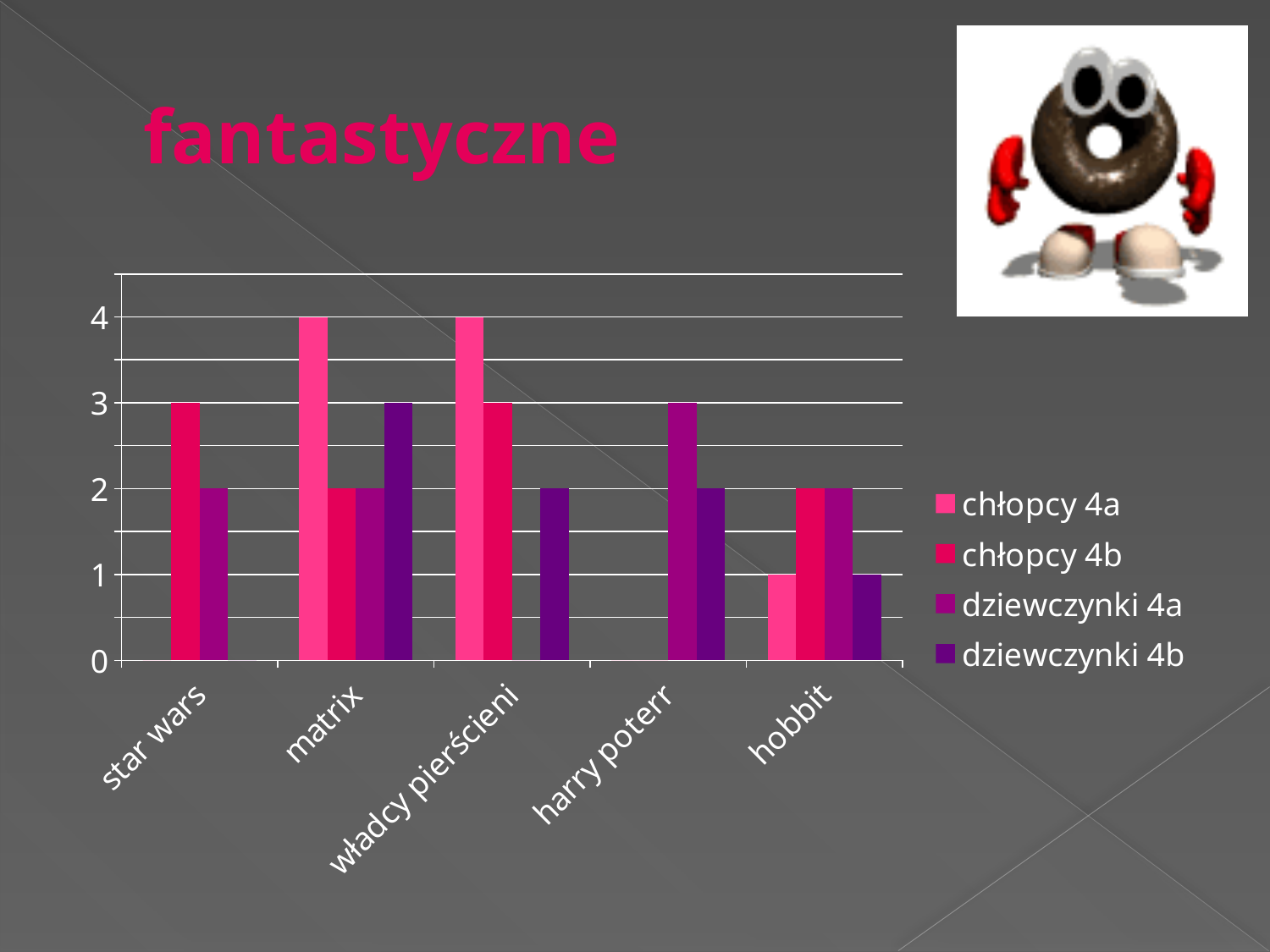
Which category has the lowest value for chłopcy 4b? harry poterr What kind of chart is shown on the slide? bar chart What is the value for chłopcy 4a for matrix? 4 What is the difference between chłopcy 4a and chłopcy 4b for władcy pierścieni? 1 What is the value for chłopcy 4b for star wars? 3 How many categories are shown on the x axis? 5 Which is larger for hobbit: chłopcy 4a or chłopcy 4b? chłopcy 4b What is the title of the slide? fantastyczne What is the value for dziewczynki 4b for hobbit? 1 How many series does the legend list? 4 Which category has the highest value for dziewczynki 4b? matrix What is the value for dziewczynki 4a for harry poterr? 3